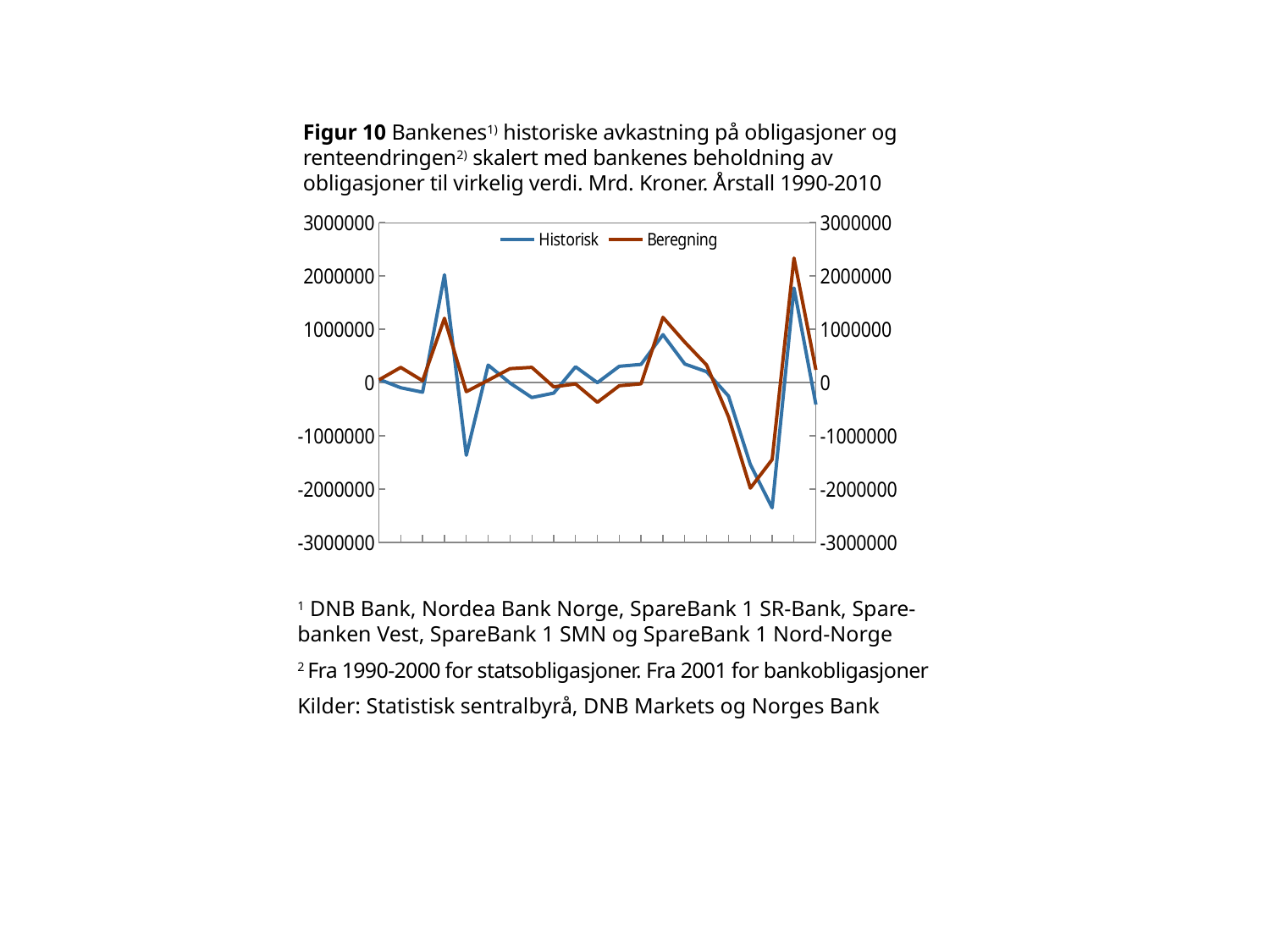
Is the highest value reached by the Beregning series greater or less than 2000000? greater What are the names of the two series in the legend? Historisk and Beregning What kind of chart is shown on the slide? Line chart Is the highest value reached by the Historisk series greater or less than 1000000? greater Which series reaches the higher peak value, Historisk or Beregning? Beregning Which series reaches the lower minimum value, Historisk or Beregning? Historisk Is the lowest value reached by the Beregning series greater or less than -1000000? less Which colour is used for the Historisk series? Blue What is the highest value shown on the vertical axis? 3000000 How many series does the legend list? 2